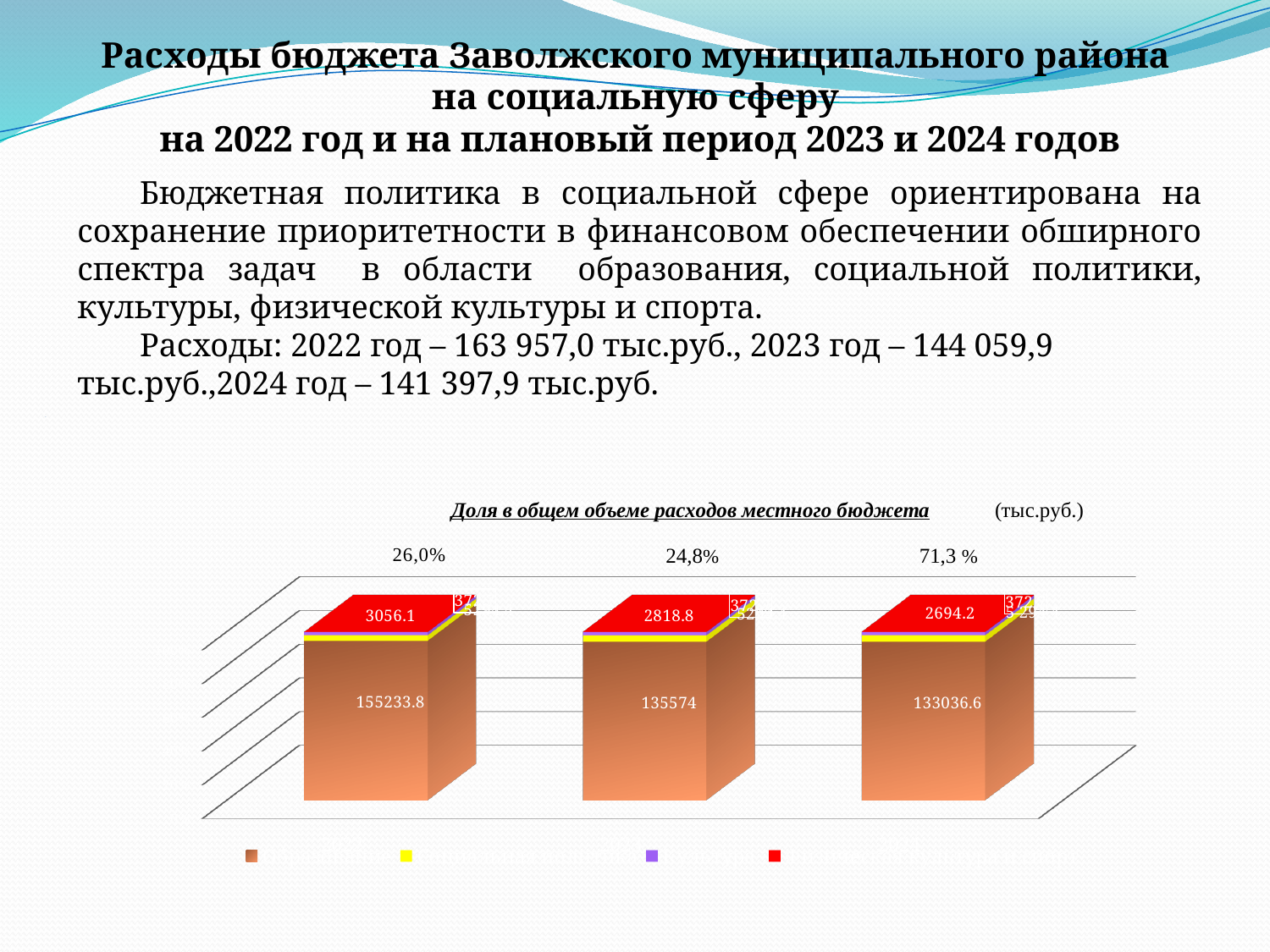
What is the difference between the brown segment values of the left bar (155233.8) and the middle bar (135574)? 19659.8 What percentage label is printed above the right bar? 71,3 % What is the value printed on the large brown segment of the middle bar? 135574 What kind of chart is shown on the slide? bar chart How many bars are plotted in the chart? 3 What is the value printed on the red top segment of the right bar? 2694.2 How many series does the chart legend list? 4 Do the values of the large brown segment rise or fall from the left bar to the right bar? fall Which bar has the highest value for the large brown segment? the left bar What is the value printed on the red top segment of the left bar? 3056.1 What is the value printed on the large brown segment of the right bar? 133036.6 What is the value printed on the large brown segment of the left bar? 155233.8